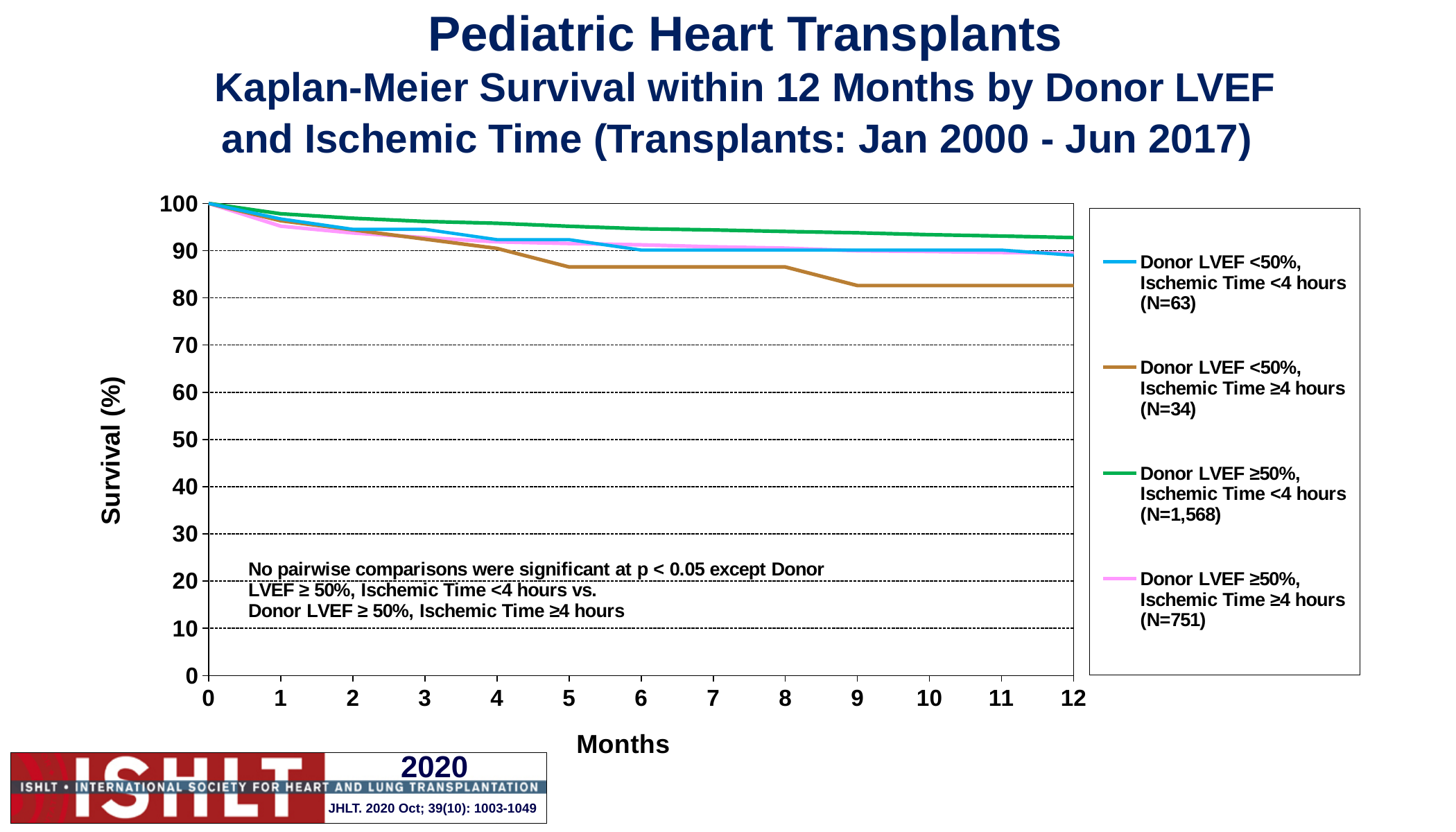
Do the survival curves rise or fall as months increase? fall Which series has the highest survival at 12 months? Donor LVEF ≥50%, Ischemic Time <4 hours How many series does the legend list? 4 Is the survival for Donor LVEF <50%, Ischemic Time ≥4 hours at 12 months greater or less than 90? less Which series has the lowest survival at 12 months? Donor LVEF <50%, Ischemic Time ≥4 hours At 5 months, which series has higher survival: Donor LVEF ≥50%, Ischemic Time <4 hours or Donor LVEF <50%, Ischemic Time ≥4 hours? Donor LVEF ≥50%, Ischemic Time <4 hours What kind of chart is shown on the slide? line chart What is the label of the y axis? Survival (%) What is the N for the Donor LVEF ≥50%, Ischemic Time <4 hours series in the legend? N=1,568 Is the survival for Donor LVEF <50%, Ischemic Time ≥4 hours at 9 months greater or less than 90? less Is the survival for Donor LVEF ≥50%, Ischemic Time <4 hours at 12 months greater or less than 90? greater What is the survival value for all series at month 0? 100